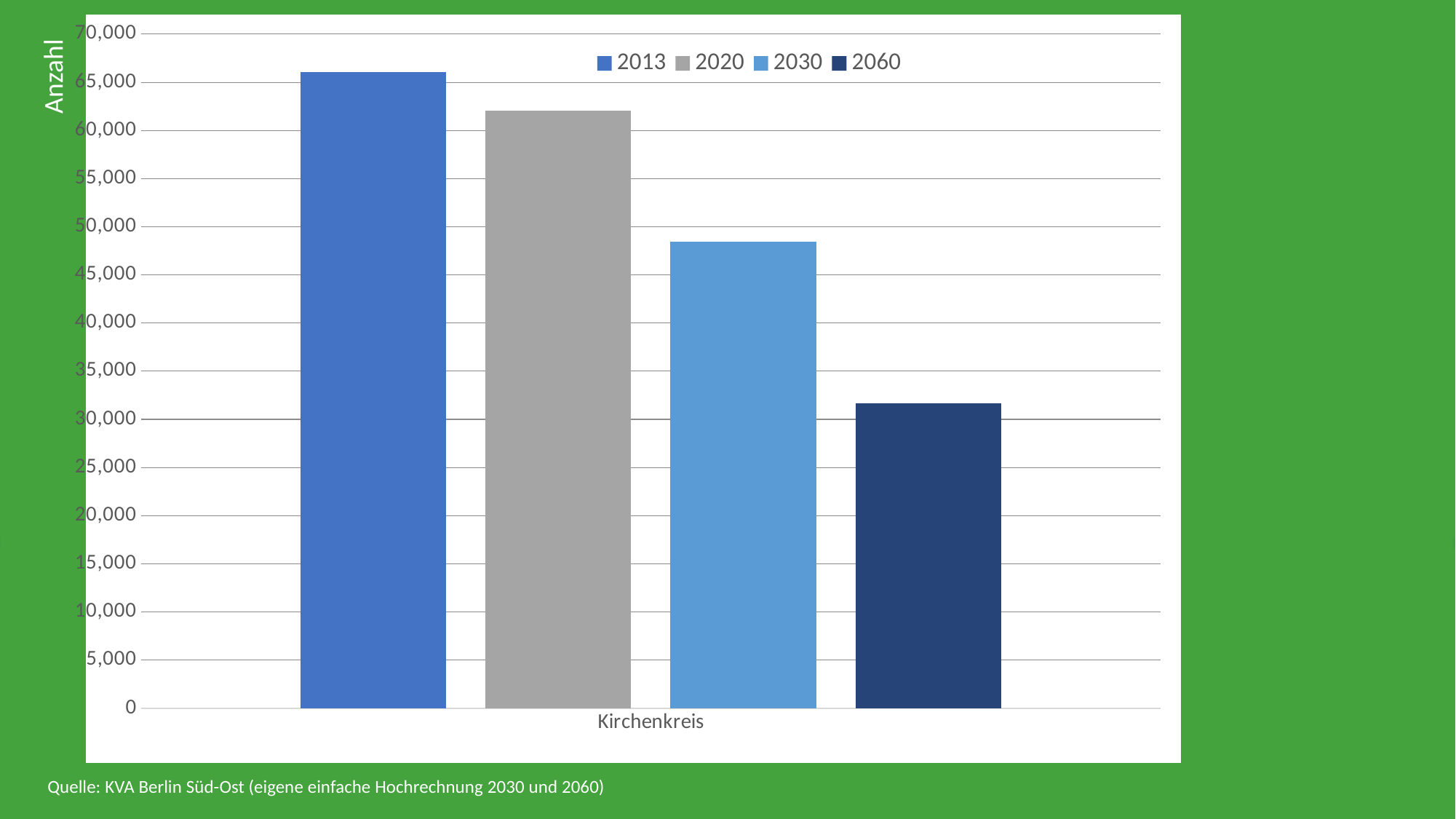
Do the bars rise or fall from 2013 to 2060? fall Which is larger, the bar for 2030 or the bar for 2060? 2030 Which series has the lowest bar? 2060 Is the value for 2060 greater or less than 30,000? greater What is the label on the vertical axis? Anzahl How many series does the legend list? 4 Is the value for 2013 greater or less than 65,000? greater What kind of chart is shown on the slide? bar chart Is the value for 2020 greater or less than 60,000? greater Which series has the highest bar? 2013 Which is larger, the bar for 2020 or the bar for 2030? 2020